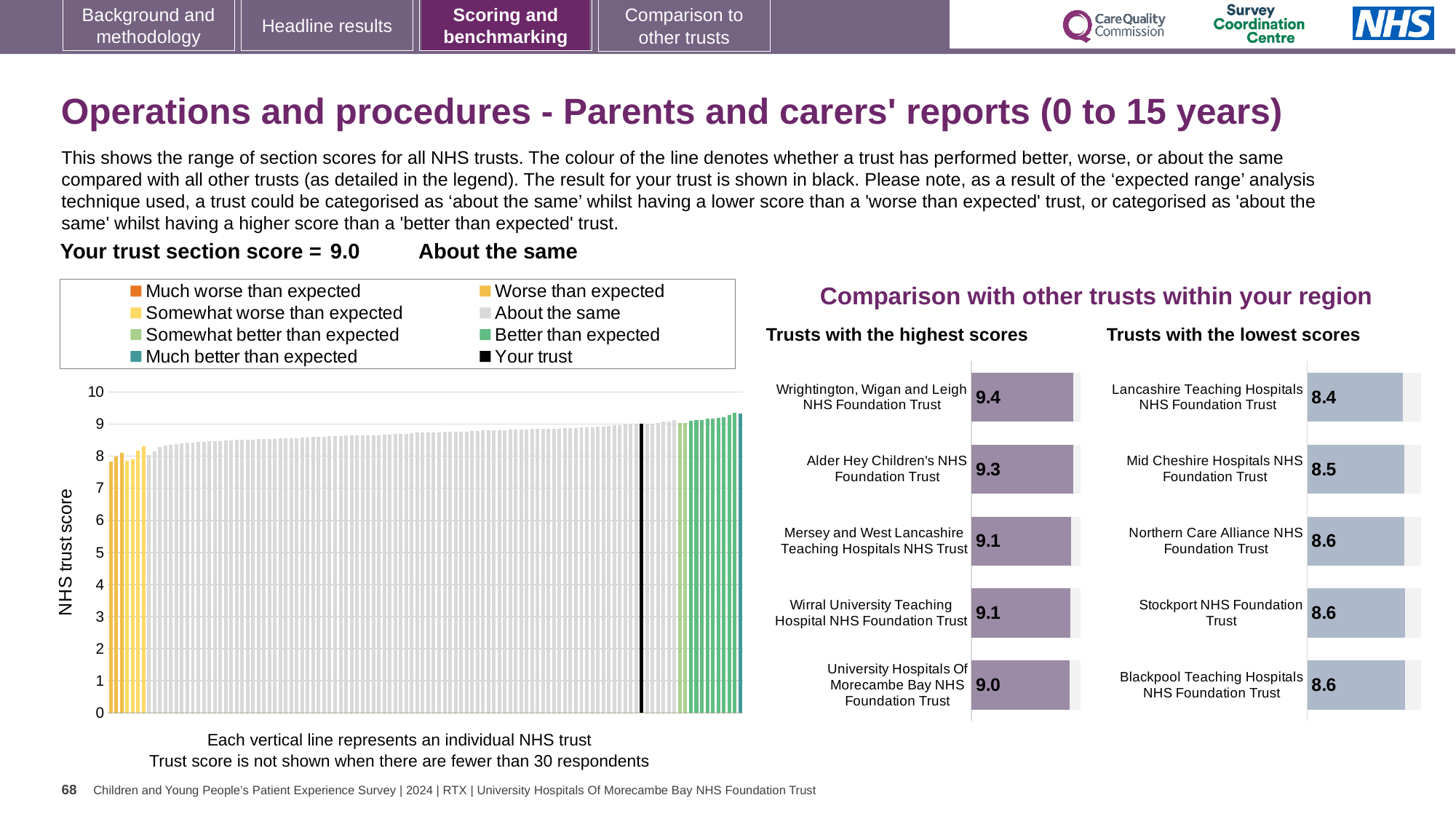
In the 'Trusts with the highest scores' chart, what is the score for Wrightington, Wigan and Leigh NHS Foundation Trust? 9.4 In the 'Trusts with the highest scores' chart, what is the difference between the scores of Wrightington, Wigan and Leigh NHS Foundation Trust and University Hospitals Of Morecambe Bay NHS Foundation Trust? 0.4 In the 'Trusts with the highest scores' chart, which trust has the highest score? Wrightington, Wigan and Leigh NHS Foundation Trust In the 'Trusts with the lowest scores' chart, what is the score for Mid Cheshire Hospitals NHS Foundation Trust? 8.5 In the large chart on the left, do the trust scores rise or fall from left to right along the x axis? Rise How many trusts are shown in the 'Trusts with the lowest scores' chart? 5 What kind of chart is the large chart on the left showing NHS trust scores? Bar chart Which score is larger: Alder Hey Children's NHS Foundation Trust in the highest scores chart or Mid Cheshire Hospitals NHS Foundation Trust in the lowest scores chart? Alder Hey Children's NHS Foundation Trust In the 'Trusts with the lowest scores' chart, which trust has the lowest score? Lancashire Teaching Hospitals NHS Foundation Trust In the 'Trusts with the highest scores' chart, what is the score for Alder Hey Children's NHS Foundation Trust? 9.3 In the 'Trusts with the lowest scores' chart, what is the score for Lancashire Teaching Hospitals NHS Foundation Trust? 8.4 How many entries does the legend above the large chart on the left list? 8